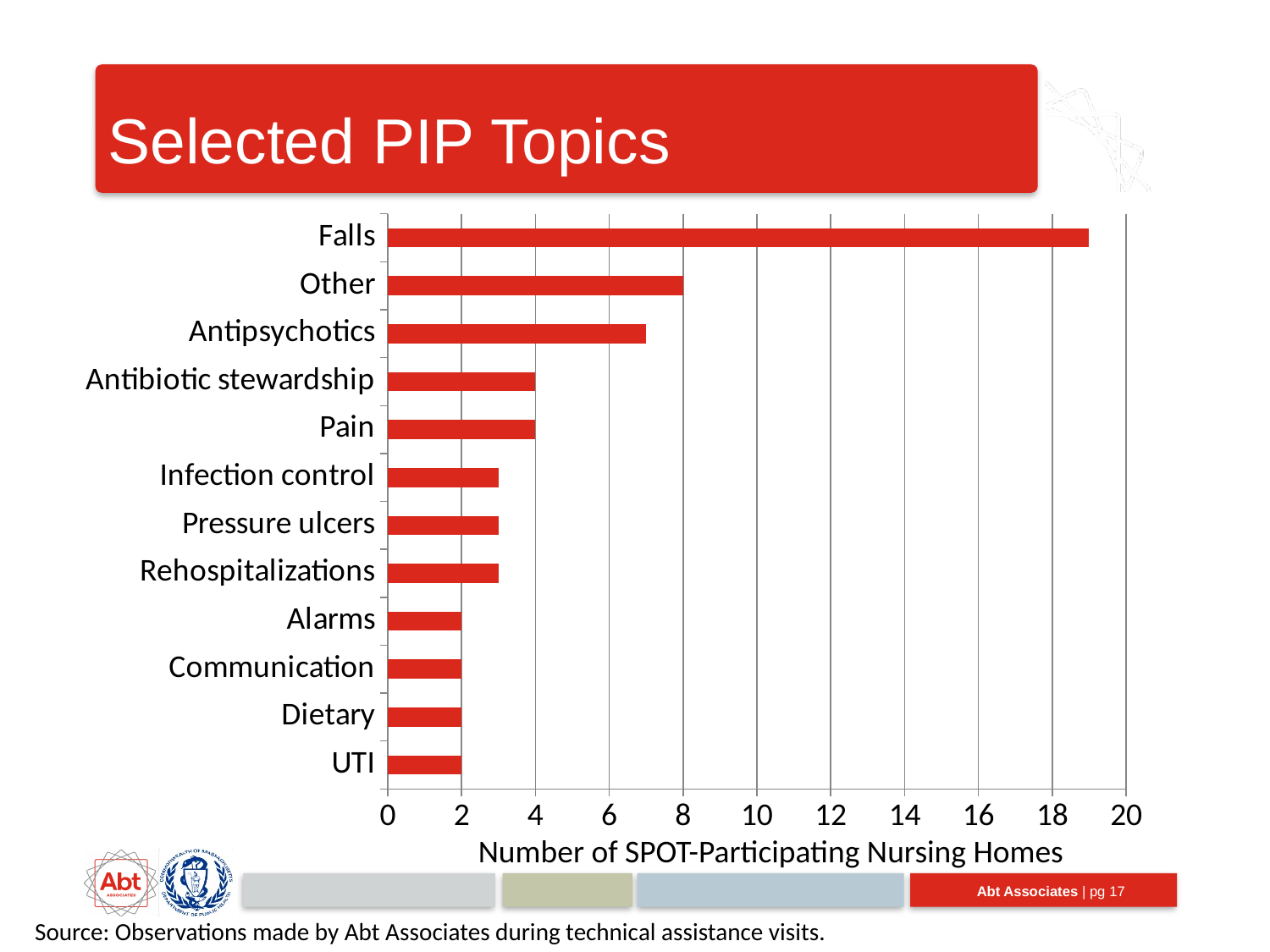
Is the value for Falls greater or less than 18? greater What is the number of SPOT-participating nursing homes for Other? 8 Which PIP topic has the highest number of SPOT-participating nursing homes? Falls What is the difference between the values for Other and Pain? 4 Is the value for Antipsychotics greater or less than 6? greater What is the number of SPOT-participating nursing homes for Pain? 4 How many PIP topics are listed on the chart? 12 What is the number of SPOT-participating nursing homes for Antibiotic stewardship? 4 What is the number of SPOT-participating nursing homes for UTI? 2 Is the value for Infection control greater or less than 4? less What kind of chart is shown on the slide? Bar chart Which has more SPOT-participating nursing homes, Other or Antipsychotics? Other